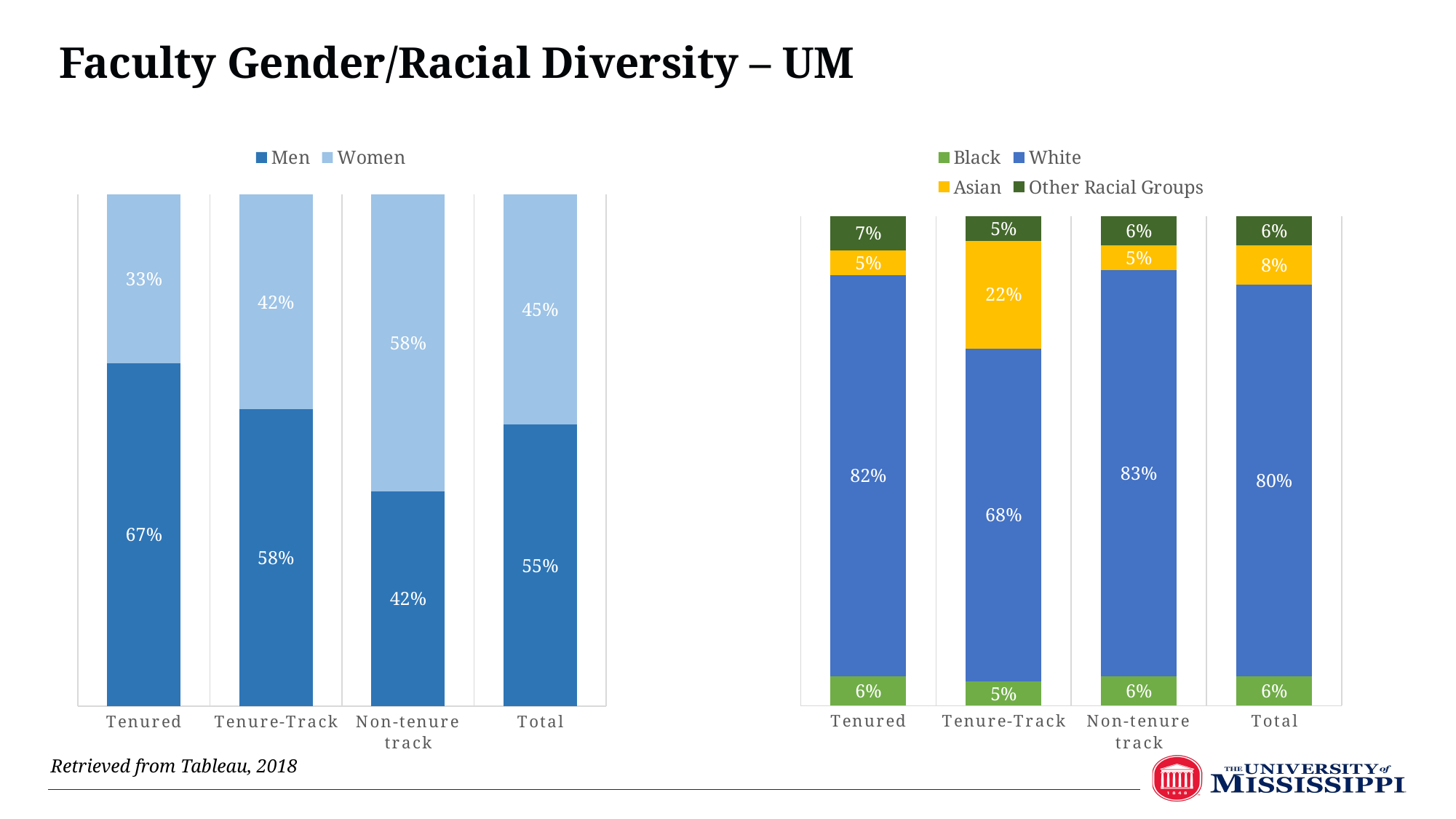
In the right chart, what percentage of Non-tenure track faculty are White? 83% In the right chart, which category has the lowest percentage of White faculty? Tenure-Track In the left chart, which category has the lowest percentage of Men? Non-tenure track What kind of chart is the left chart? Stacked bar chart In the right chart, how many categories are shown on the x axis? 4 In the right chart, how many series does the legend list? 4 In the right chart, is the Asian percentage larger for Tenure-Track or for Total? Tenure-Track In the right chart, what percentage of Tenure-Track faculty are Asian? 22% In the left chart, what percentage of Tenured faculty are Men? 67% In the left chart, how many series does the legend list? 2 In the left chart, what percentage of Non-tenure track faculty are Women? 58% In the left chart, what is the difference between the Men percentage for Tenured and the Men percentage for Tenure-Track? 9%